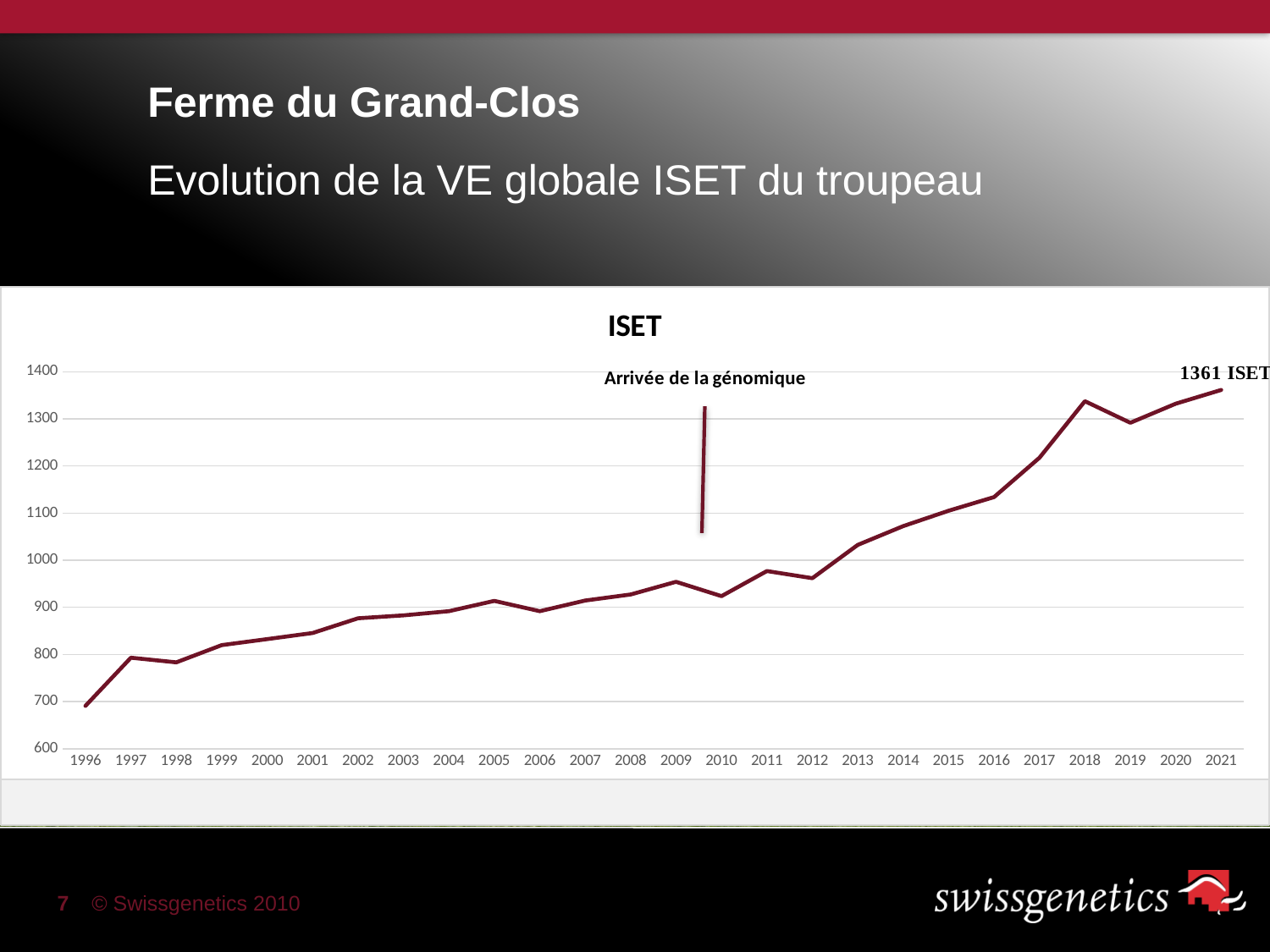
Is the value for 2010 greater or less than 1000? less Is the value for 2015 greater or less than 1000? greater What kind of chart is shown on the slide? line chart What is the ISET value for 2021? 1361 What event does the annotation on the chart mark? Arrivée de la génomique How many years are plotted on the x axis? 26 Which year has the higher ISET value, 2018 or 2019? 2018 Which year has the highest ISET value? 2021 Which year has the lowest ISET value? 1996 Is the value for 2002 greater or less than 900? less Overall, do the ISET values rise or fall from 1996 to 2021? rise